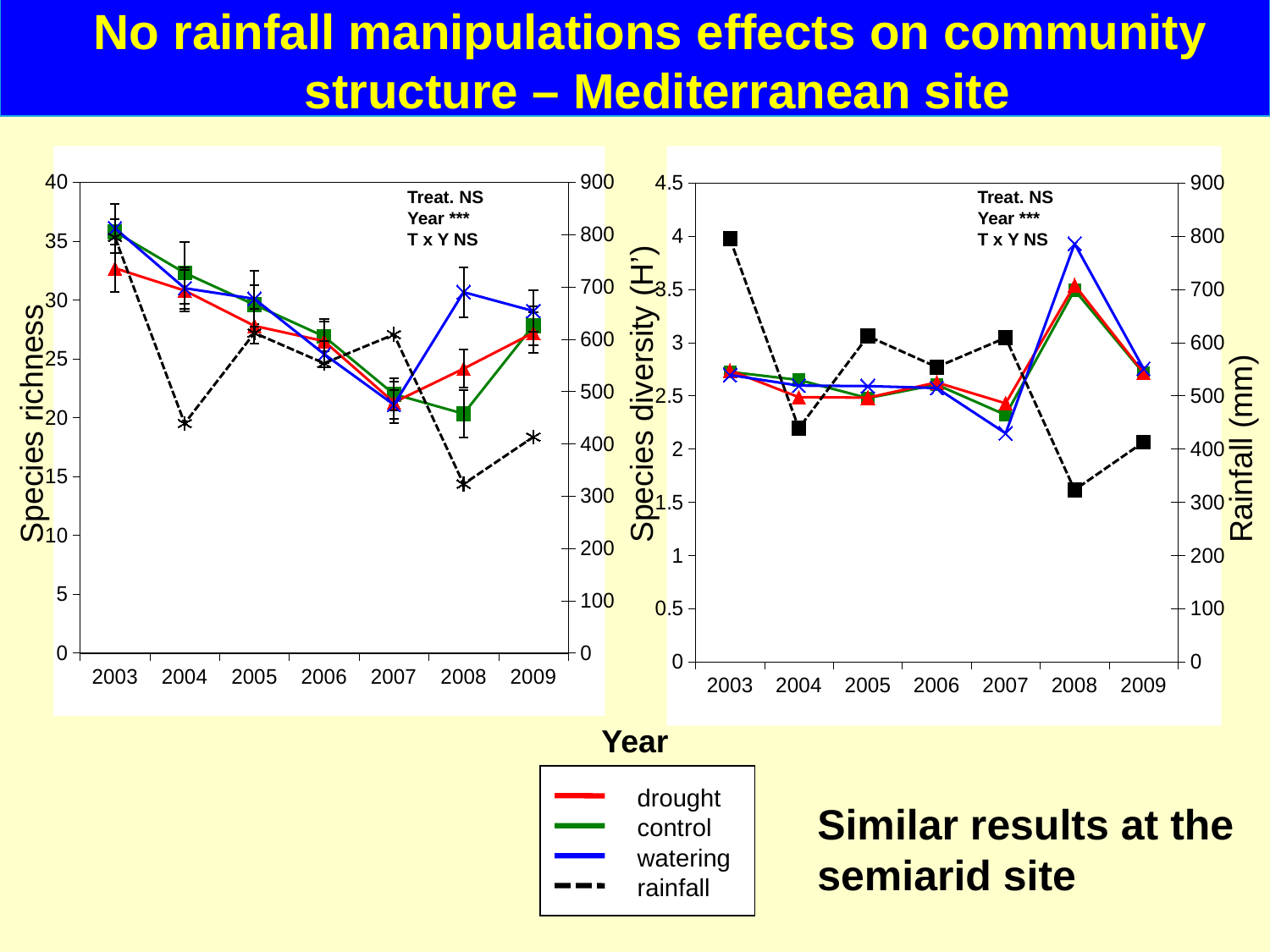
In the left chart (Species richness), which is larger in 2008: the watering value or the control value? watering In the left chart (Species richness), which year has the lowest rainfall? 2008 In the right chart (Species diversity), which year has the highest species diversity for the watering series? 2008 How many years are shown on the x axis of the right chart (Species diversity)? 7 How many series does the legend list? 4 In the left chart (Species richness), is the rainfall value for 2003 greater or less than 700? greater In the left chart (Species richness), is the rainfall value for 2008 greater or less than 400? less What kind of chart is the left chart (Species richness)? line chart In the left chart (Species richness), does the control series rise or fall from 2003 to 2007? fall In the right chart (Species diversity), is the watering value for 2008 greater or less than 3.5? greater In the left chart (Species richness), which year has the highest rainfall? 2003 What does the black dashed line in the legend represent? rainfall